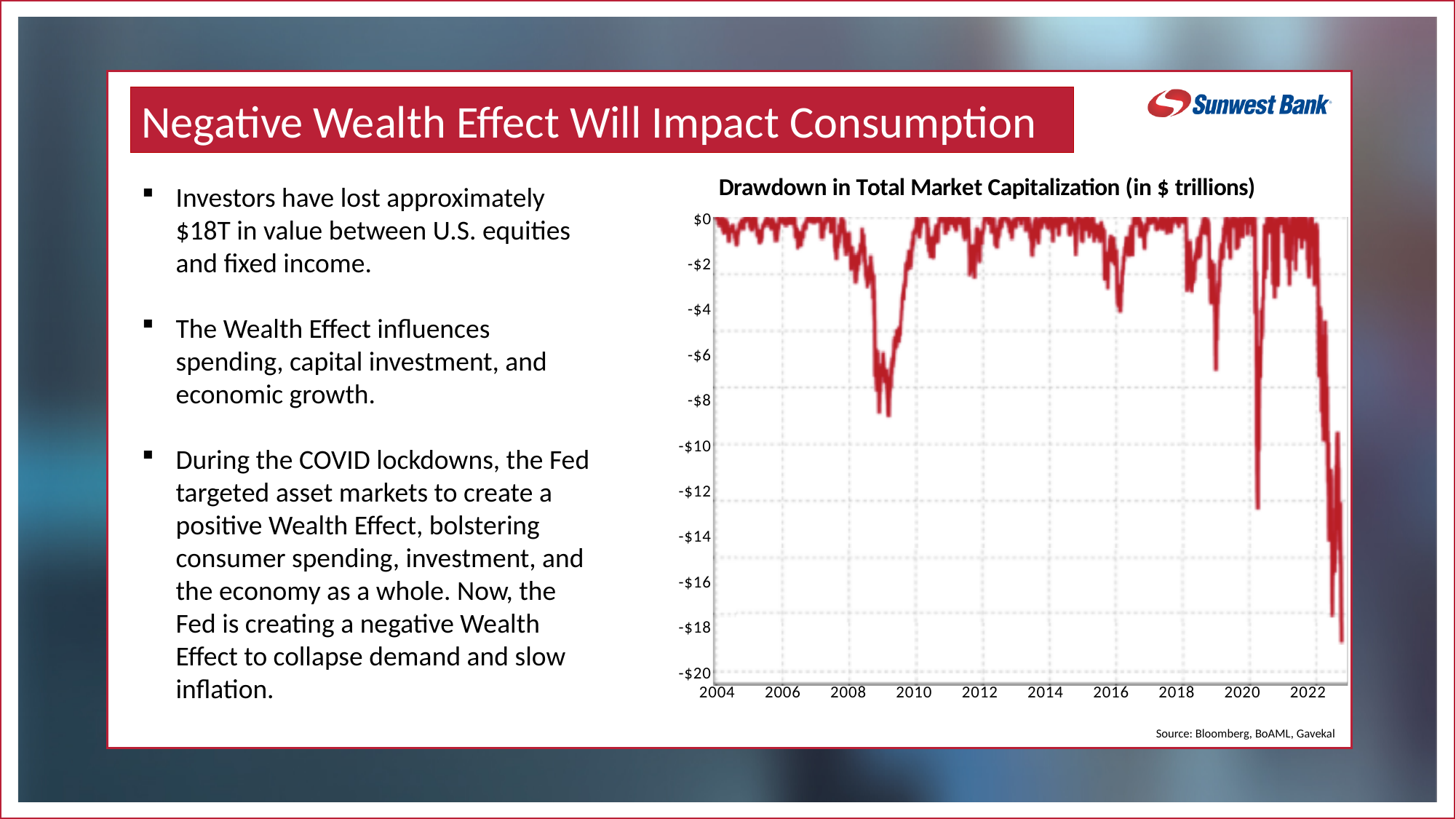
What is the title of the chart? Drawdown in Total Market Capitalization (in $ trillions) What is the first year shown on the x axis? 2004 Which drawdown is deeper: the trough around 2009 or the trough in 2022? 2022 In which year does the line reach its lowest point? 2022 What is the lowest value labelled on the y axis? -$20 Is the deepest point of the 2009 drawdown greater or less than -$8 trillion? less Is the deepest point of the 2020 drawdown greater or less than -$10 trillion? less Is the deepest point of the 2022 drawdown greater or less than -$18 trillion? less What kind of chart is shown on the slide? line chart Does the line rise or fall from the start of 2022 to the end of the chart? fall How many year labels are shown on the x axis? 10